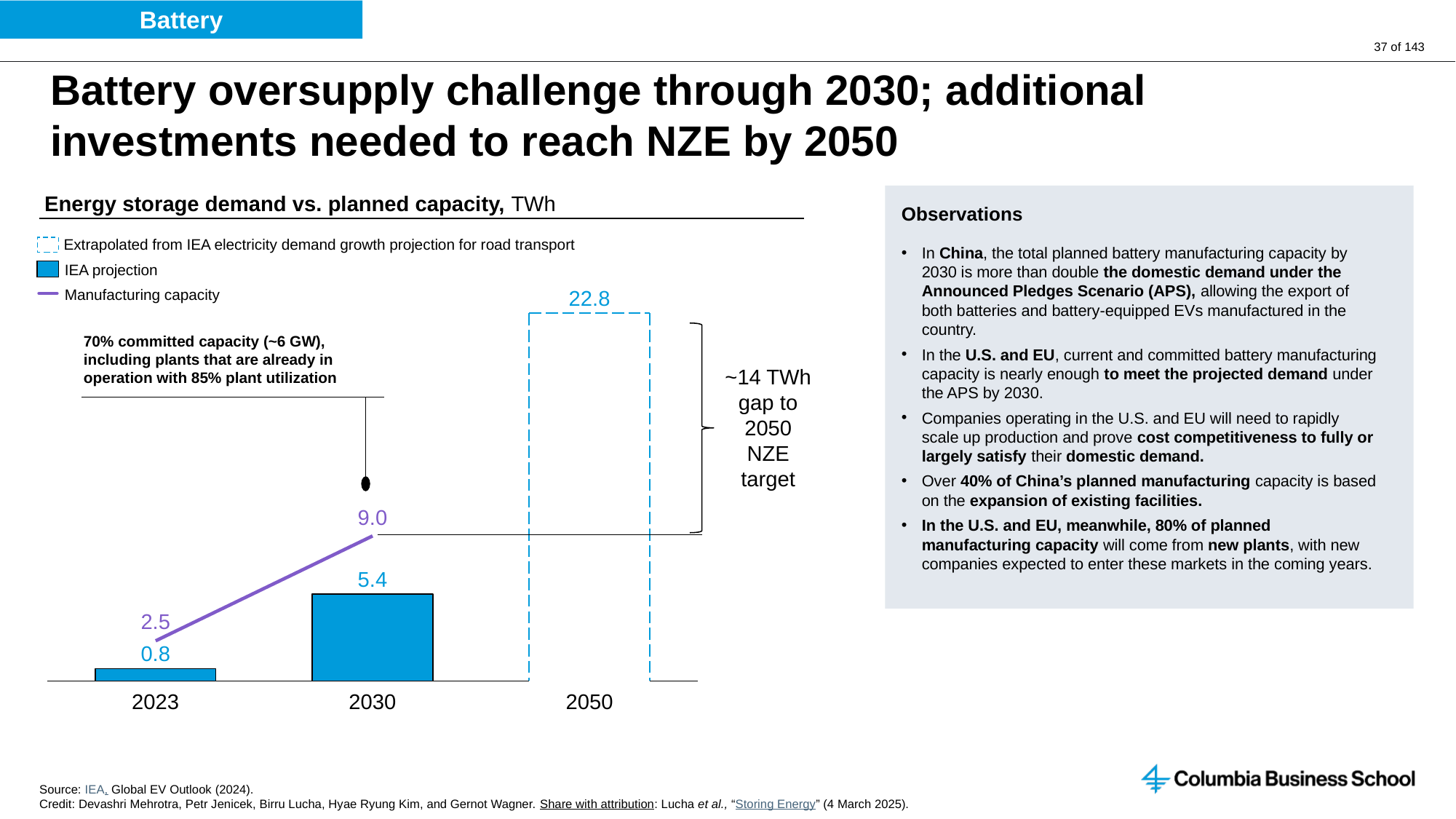
In 2030, which is larger: manufacturing capacity or energy storage demand? Manufacturing capacity By how much does manufacturing capacity increase from 2023 (2.5) to 2030 (9.0)? 6.5 What is the extrapolated energy storage demand value shown for 2050? 22.8 Which year has the highest energy storage demand value on the chart? 2050 What is the energy storage demand value shown for 2023? 0.8 Which year has the lowest energy storage demand value on the chart? 2023 How many years are shown on the x axis of the chart? 3 What unit is the chart measured in, according to its title? TWh What is the difference between the 2050 demand value (22.8) and the 2030 demand value (5.4)? 17.4 What is the manufacturing capacity value shown for 2023? 2.5 What is the manufacturing capacity value shown for 2030? 9.0 What is the energy storage demand value shown for 2030? 5.4